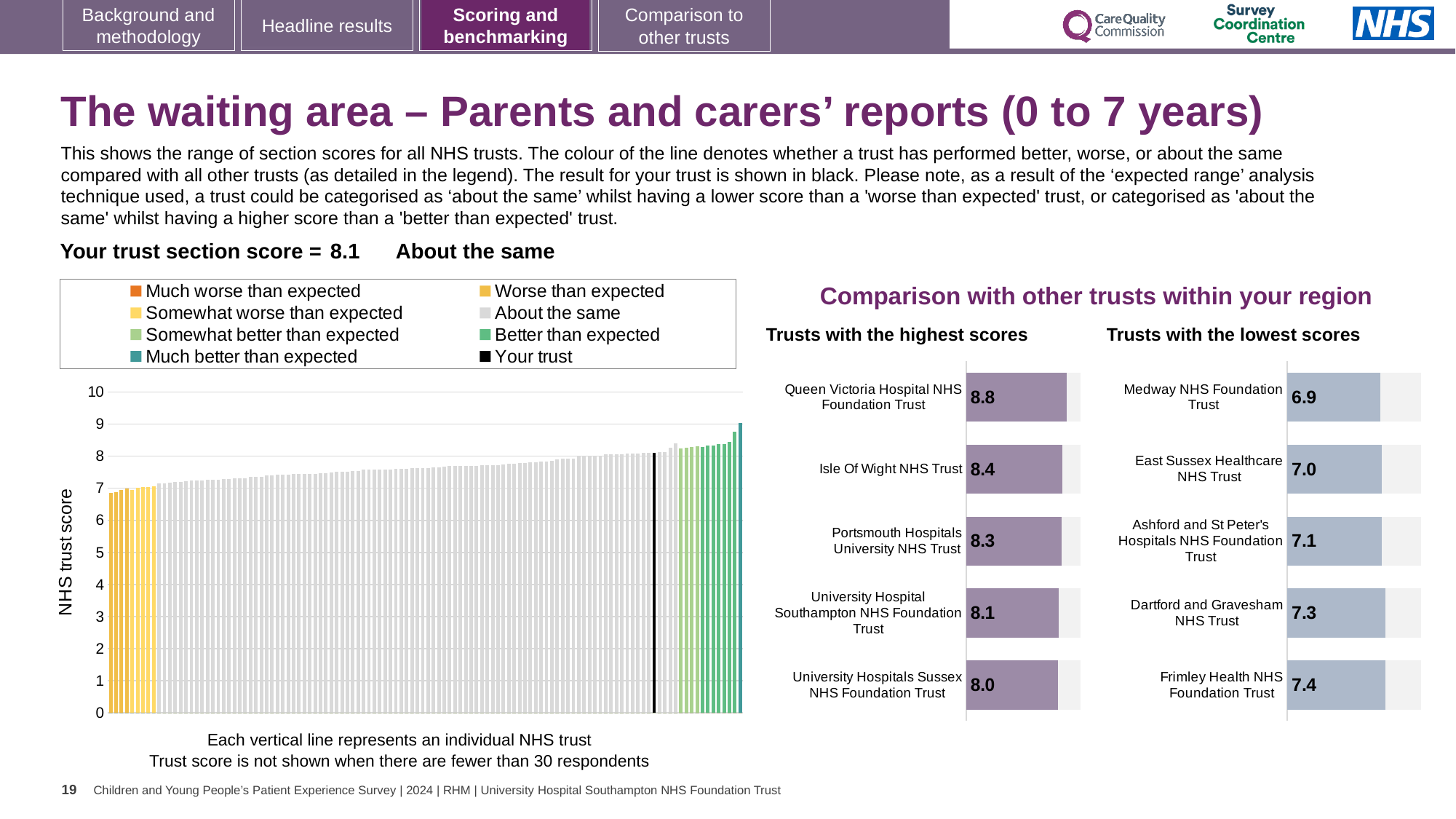
In the 'Trusts with the highest scores' chart, which trust has the lowest score? University Hospitals Sussex NHS Foundation Trust In the 'Trusts with the lowest scores' chart, which trust has the highest score? Frimley Health NHS Foundation Trust How many entries does the legend above the NHS trust score chart list? 8 What kind of chart is the NHS trust score chart on the left? bar chart In the 'Trusts with the lowest scores' chart, which has the larger score: Dartford and Gravesham NHS Trust or Ashford and St Peter's Hospitals NHS Foundation Trust? Dartford and Gravesham NHS Trust In the NHS trust score chart on the left, is the value of the tallest bar greater or less than 8? greater In the 'Trusts with the lowest scores' chart, how many trusts are listed? 5 In the 'Trusts with the lowest scores' chart, what is the score for Medway NHS Foundation Trust? 6.9 In the 'Trusts with the highest scores' chart, what is the score for Portsmouth Hospitals University NHS Trust? 8.3 In the 'Trusts with the highest scores' chart, what is the score for Queen Victoria Hospital NHS Foundation Trust? 8.8 In the NHS trust score chart on the left, do the bar values rise or fall from left to right? rise In the 'Trusts with the highest scores' chart, what is the difference between the scores of Queen Victoria Hospital NHS Foundation Trust and University Hospitals Sussex NHS Foundation Trust? 0.8